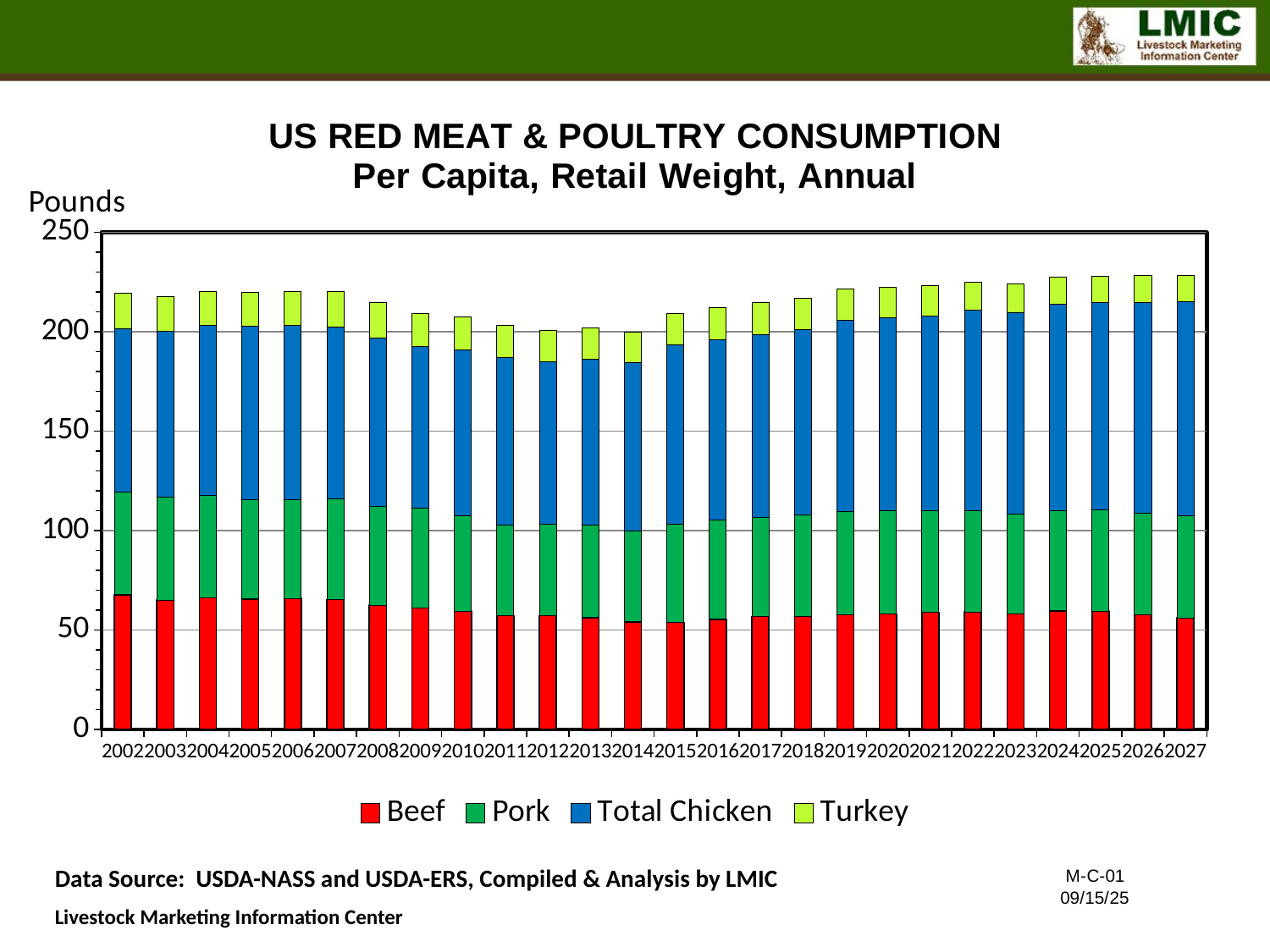
Is the total height of the stacked bar for 2024 greater or less than 200? greater Which year has the larger Beef value, 2002 or 2014? 2002 Is the total height of the stacked bar for 2002 greater or less than 200? greater Which year has the larger total stacked bar, 2002 or 2014? 2002 Is the Beef value for 2027 greater or less than 100? less How many series does the legend list? 4 Do the total stacked bar heights rise or fall from 2014 to 2027? rise Which series is shown in red in the legend? Beef What unit is labelled on the y axis? Pounds How many years are shown along the x axis? 26 What kind of chart is shown on the slide? Stacked bar chart